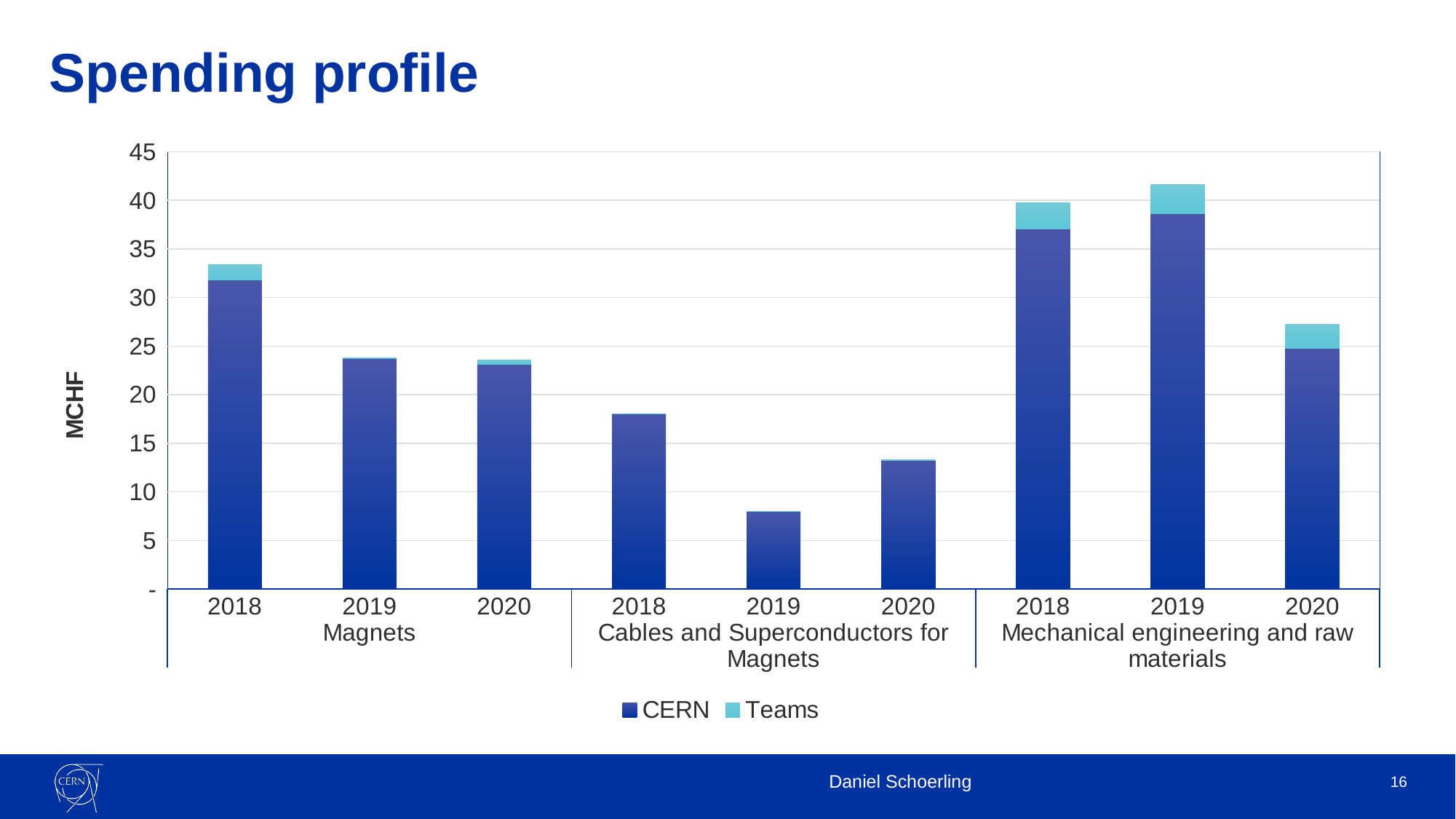
Is the total value for Cables and Superconductors for Magnets in 2019 greater or less than 10? less Is the total value for Magnets in 2018 greater or less than 30? greater What kind of chart is shown on the slide? Stacked bar chart Which bar has the lowest total spending? Cables and Superconductors for Magnets, 2019 Do the Magnets totals rise or fall from 2018 to 2020? fall How many series does the legend list? 2 How many bars are plotted in the chart? 9 Which is larger: the total for Magnets in 2018 or the total for Mechanical engineering and raw materials in 2020? Magnets in 2018 What is the label on the vertical axis? MCHF Is the total value for Mechanical engineering and raw materials in 2019 greater or less than 40? greater Which bar has the highest total spending? Mechanical engineering and raw materials, 2019